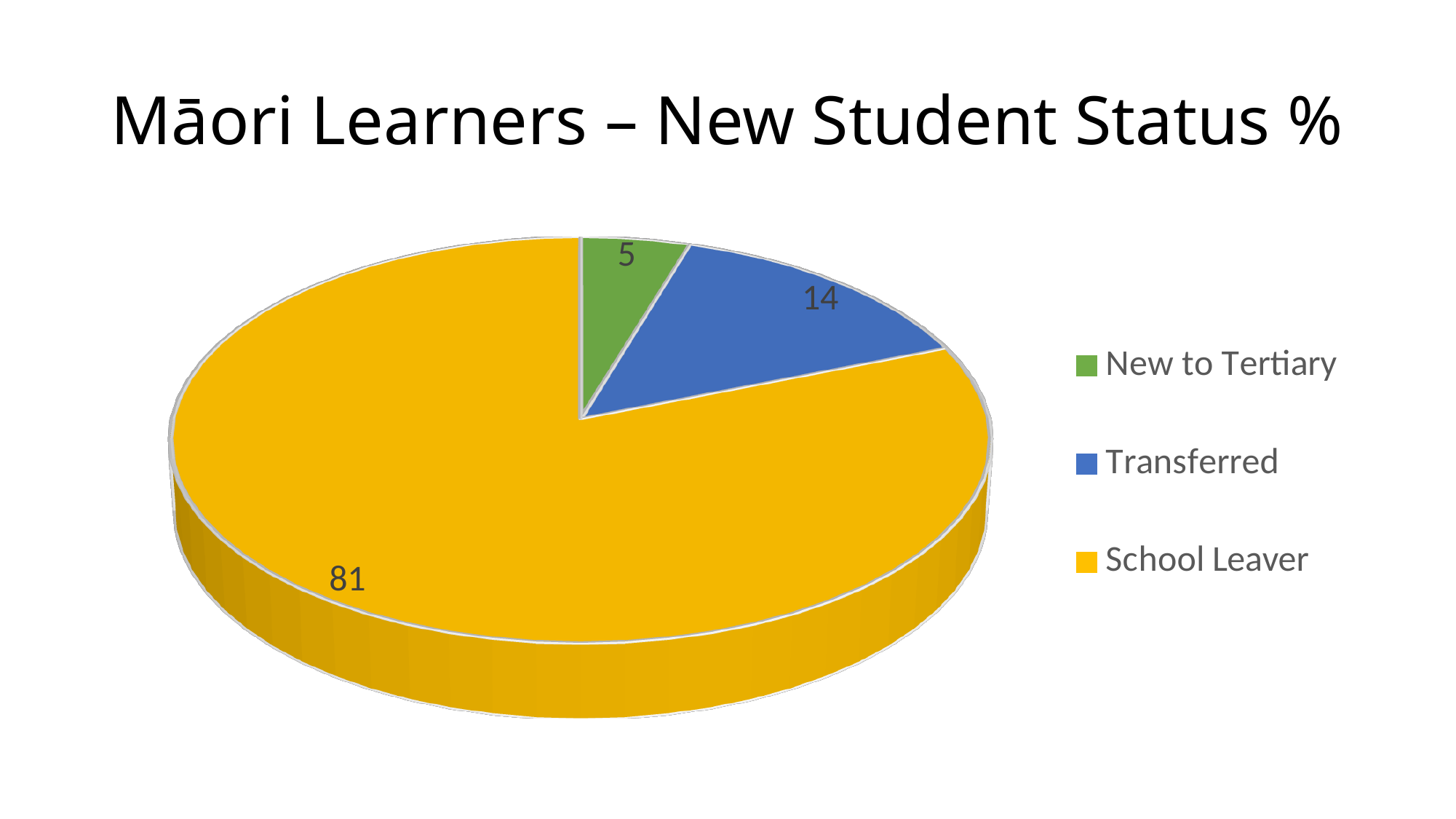
What is the difference between the School Leaver and Transferred values? 67 What is the value for New to Tertiary? 5 What is the title of the chart? Māori Learners – New Student Status % Which is larger, Transferred or New to Tertiary? Transferred How many categories does the pie chart show? 3 What is the difference between the Transferred and New to Tertiary values? 9 What colour is the School Leaver slice? Yellow What is the value for Transferred? 14 What kind of chart is shown on the slide? Pie chart Which category has the smallest slice? New to Tertiary Which category has the largest slice? School Leaver What is the value for School Leaver? 81